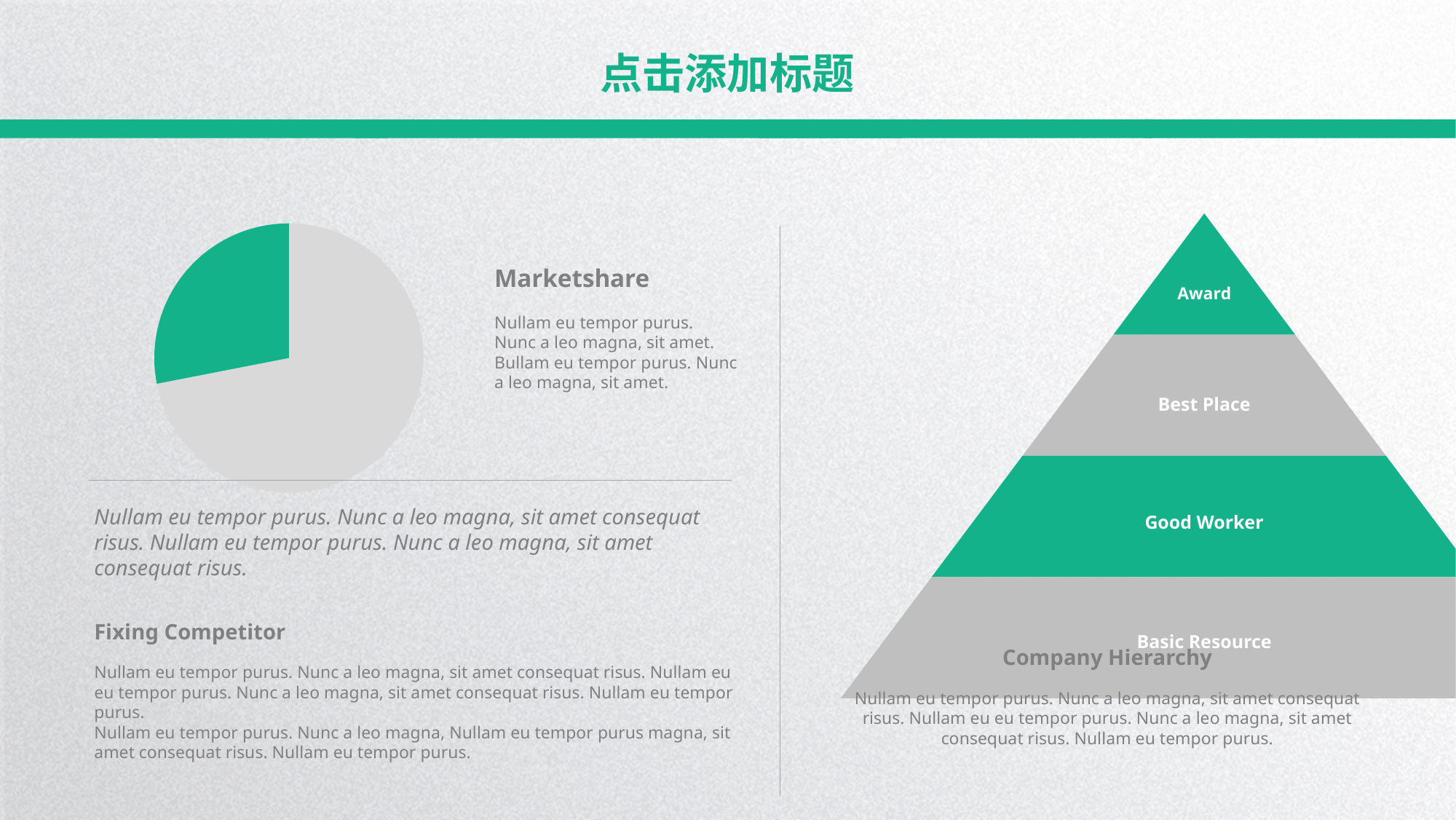
What heading appears next to the pie chart on the left? Marketshare What is the label on the top level of the pyramid diagram on the right? Award What kind of chart is shown on the left side of the slide? pie chart How many slices does the pie chart on the left have? 2 In the pie chart on the left, does the green slice cover more or less than half of the pie? less In the pie chart on the left, which slice is the largest? the grey slice How many levels does the pyramid diagram on the right have? 4 In the pie chart on the left, which slice is larger, the green one or the grey one? grey In the pie chart on the left, which slice is the smallest? the green slice